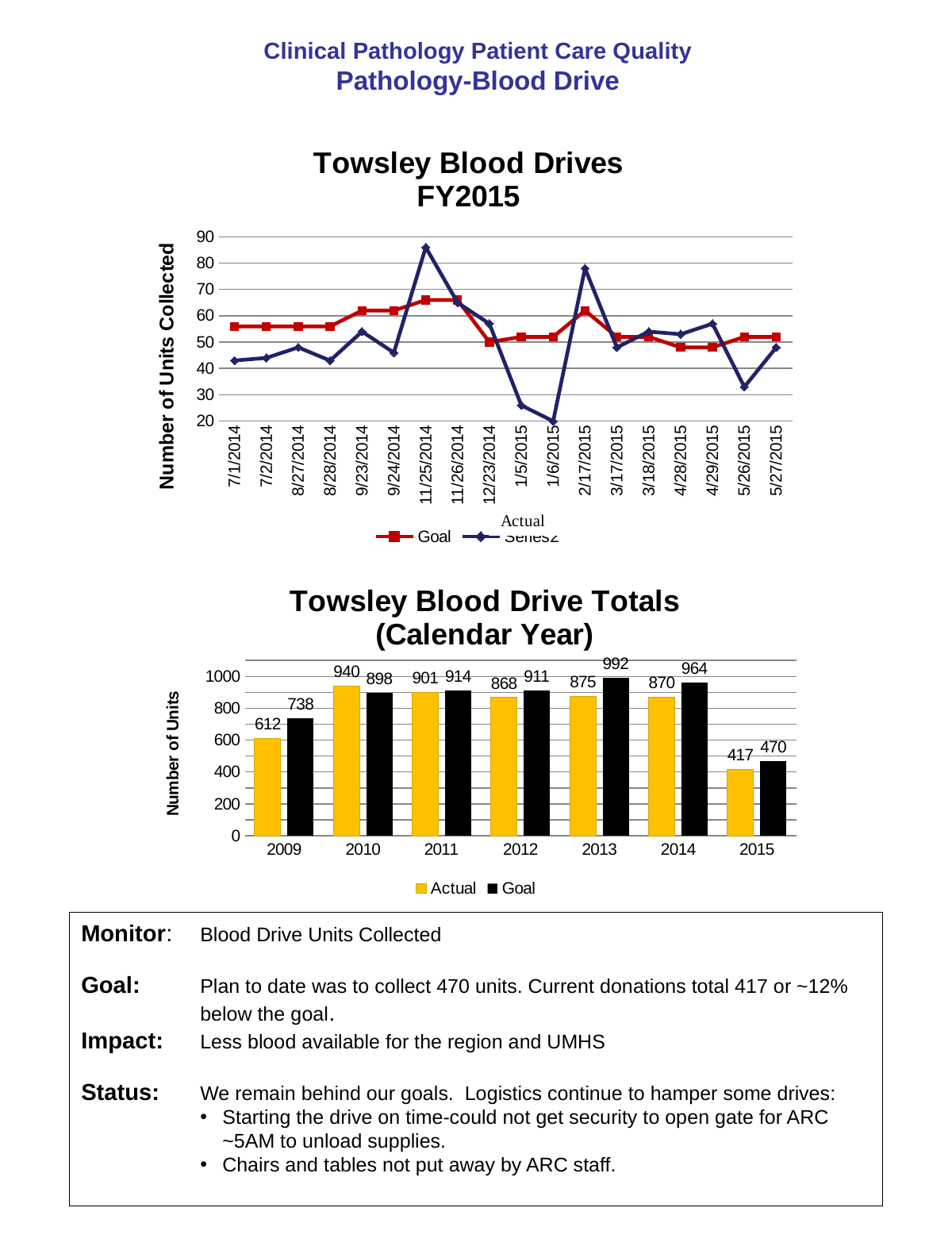
In the Towsley Blood Drive Totals (Calendar Year) chart, how many series does the legend list? 2 What kind of chart is the Towsley Blood Drive Totals (Calendar Year) chart? bar chart In the Towsley Blood Drive Totals (Calendar Year) chart, what is the Actual value for 2010? 940 What kind of chart is the Towsley Blood Drives FY2015 chart? line chart In the Towsley Blood Drives FY2015 chart, is the Actual (Series2) value for 1/6/2015 greater or less than 30? less In the Towsley Blood Drive Totals (Calendar Year) chart, is the Actual value for 2010 larger or smaller than the Goal value for 2010? larger In the Towsley Blood Drive Totals (Calendar Year) chart, how many years are shown on the x axis? 7 In the Towsley Blood Drive Totals (Calendar Year) chart, which year has the lowest Actual value? 2015 In the Towsley Blood Drive Totals (Calendar Year) chart, what is the Goal value for 2013? 992 In the Towsley Blood Drives FY2015 chart, is the Actual (Series2) value for 11/25/2014 greater or less than 80? greater In the Towsley Blood Drive Totals (Calendar Year) chart, which year has the highest Goal value? 2013 In the Towsley Blood Drive Totals (Calendar Year) chart, what is the difference between the Goal and Actual values for 2015? 53